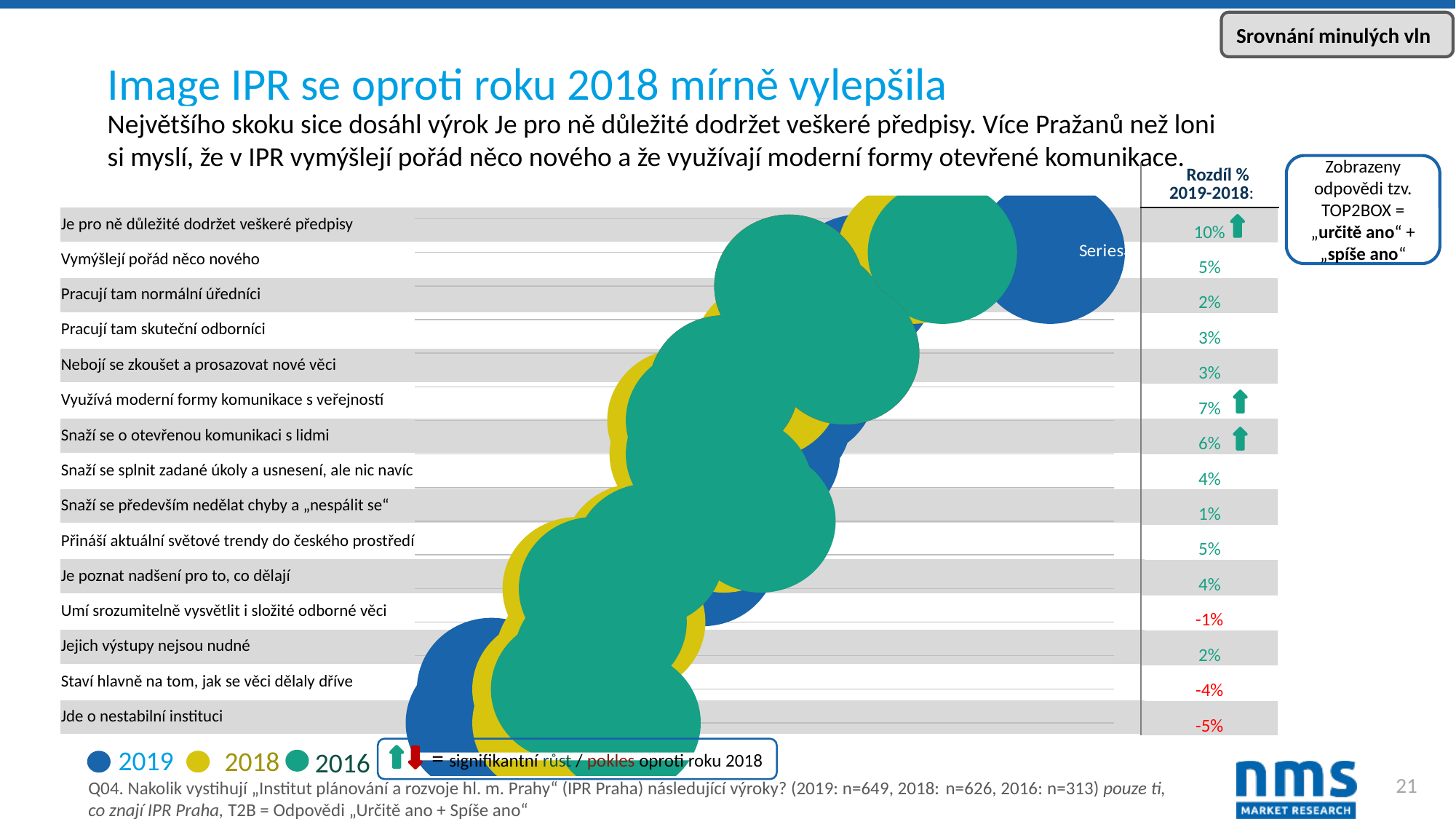
What is the 'Rozdíl % 2019-2018' value shown for 'Staví hlavně na tom, jak se věci dělaly dříve'? -4% Which colour represents the 2019 series in the legend? Blue Do the plotted values generally rise or fall going from the top statement to the bottom statement? Fall Which statement has the highest 'Rozdíl % 2019-2018' value? Je pro ně důležité dodržet veškeré předpisy How many series does the chart legend list? 3 Which years are listed in the chart legend? 2019, 2018, 2016 Which statement has the lowest 'Rozdíl % 2019-2018' value? Jde o nestabilní instituci How many statements (categories) are listed on the chart? 15 What is the 'Rozdíl % 2019-2018' value shown for 'Umí srozumitelně vysvětlit i složité odborné věci'? -1% For 'Je pro ně důležité dodržet veškeré předpisy', which series has the larger value, 2019 or 2018? 2019 What is the 'Rozdíl % 2019-2018' value shown for 'Využívá moderní formy komunikace s veřejností'? 7% What is the 'Rozdíl % 2019-2018' value shown for 'Je pro ně důležité dodržet veškeré předpisy'? 10%